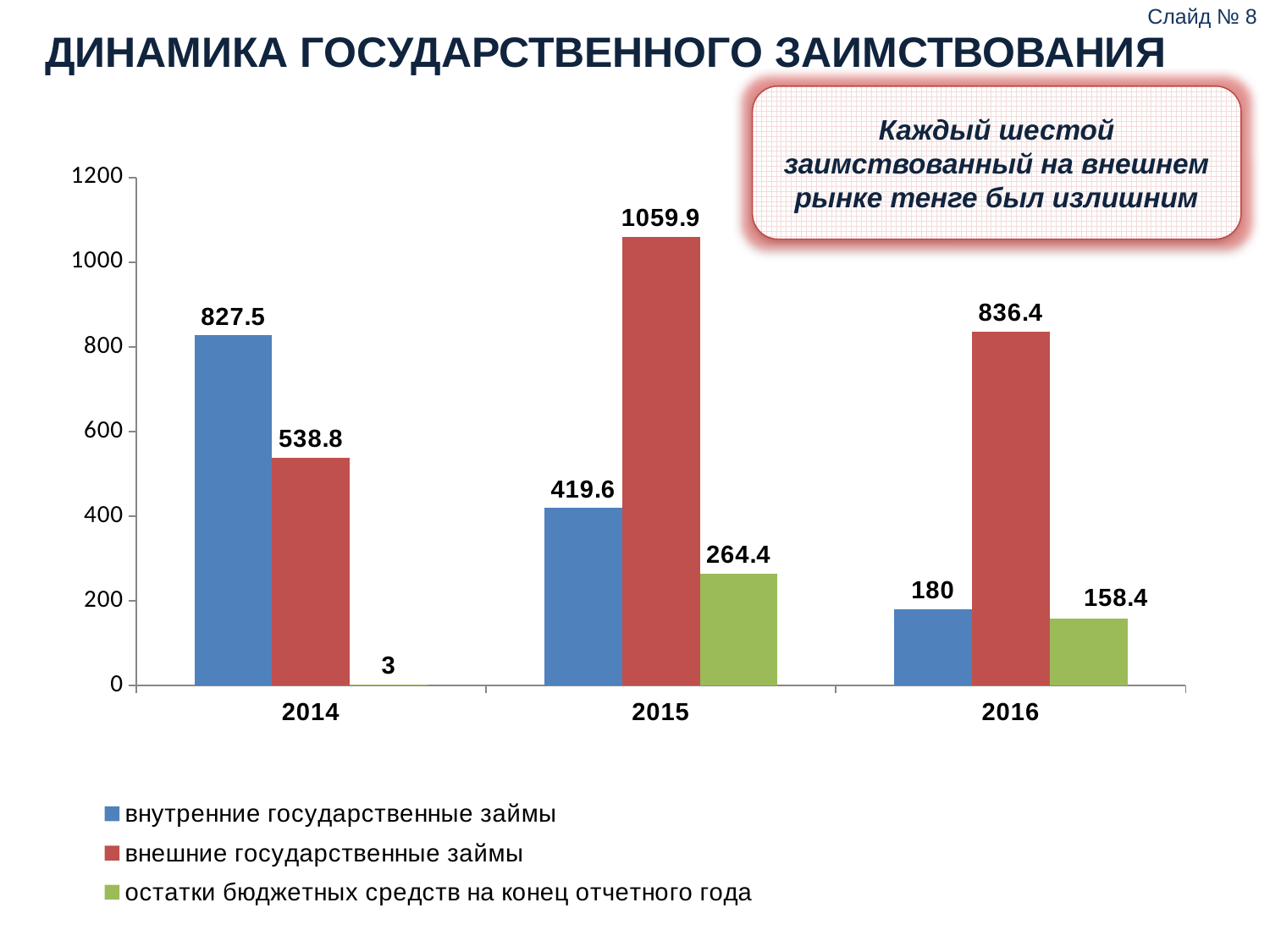
What is the value of остатки бюджетных средств на конец отчетного года in 2016? 158.4 In which year is внутренние государственные займы lowest? 2016 How many series does the legend list? 3 Does внутренние государственные займы rise or fall from 2014 to 2016? fall In which year is внешние государственные займы highest? 2015 What is the difference between внешние государственные займы in 2015 and in 2016? 223.5 How many years are shown on the x axis? 3 Which is larger in 2014: внутренние государственные займы or внешние государственные займы? внутренние государственные займы What is the value of внутренние государственные займы in 2016? 180 What is the value of внешние государственные займы in 2015? 1059.9 What is the value of внутренние государственные займы in 2014? 827.5 What kind of chart is shown on the slide? bar chart